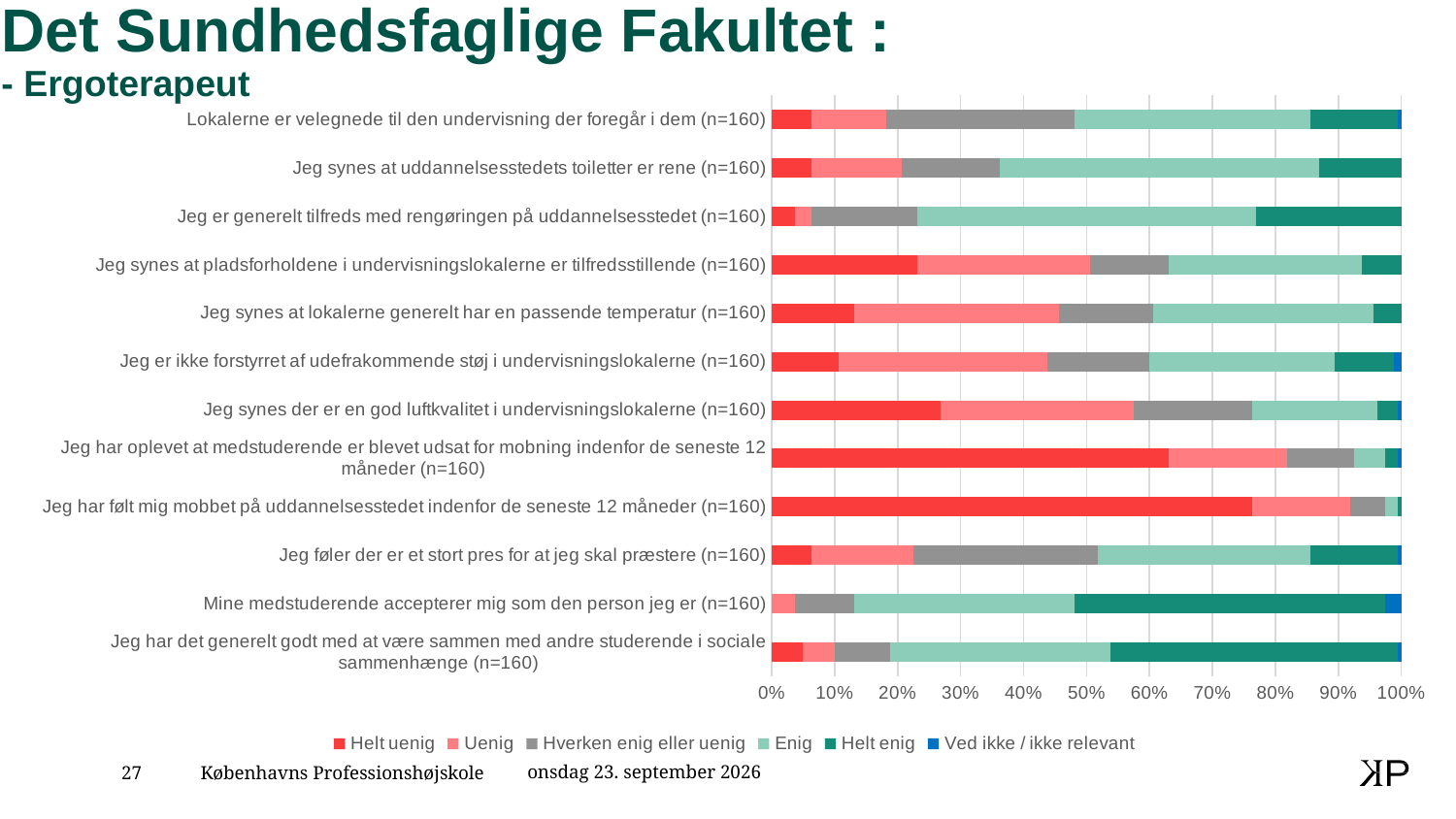
Which has the larger 'Helt uenig' share: 'Jeg synes der er en god luftkvalitet i undervisningslokalerne' or 'Jeg synes at lokalerne generelt har en passende temperatur'? Jeg synes der er en god luftkvalitet i undervisningslokalerne Which statement has the largest 'Helt uenig' segment? Jeg har følt mig mobbet på uddannelsesstedet indenfor de seneste 12 måneder (n=160) What is the sample size (n) shown for each statement? 160 Is the 'Helt uenig' share for 'Lokalerne er velegnede til den undervisning der foregår i dem' greater or less than 10%? less Is the 'Helt uenig' share for 'Jeg har oplevet at medstuderende er blevet udsat for mobning indenfor de seneste 12 måneder' greater or less than 50%? greater Which legend entry is shown in dark green? Helt enig What kind of chart is shown on the slide? Stacked bar chart How many statements (categories) are plotted in the chart? 12 Is the 'Helt uenig' share for 'Jeg har følt mig mobbet på uddannelsesstedet indenfor de seneste 12 måneder' greater or less than 70%? greater What does each stacked bar total on the x axis? 100% How many series does the legend list? 6